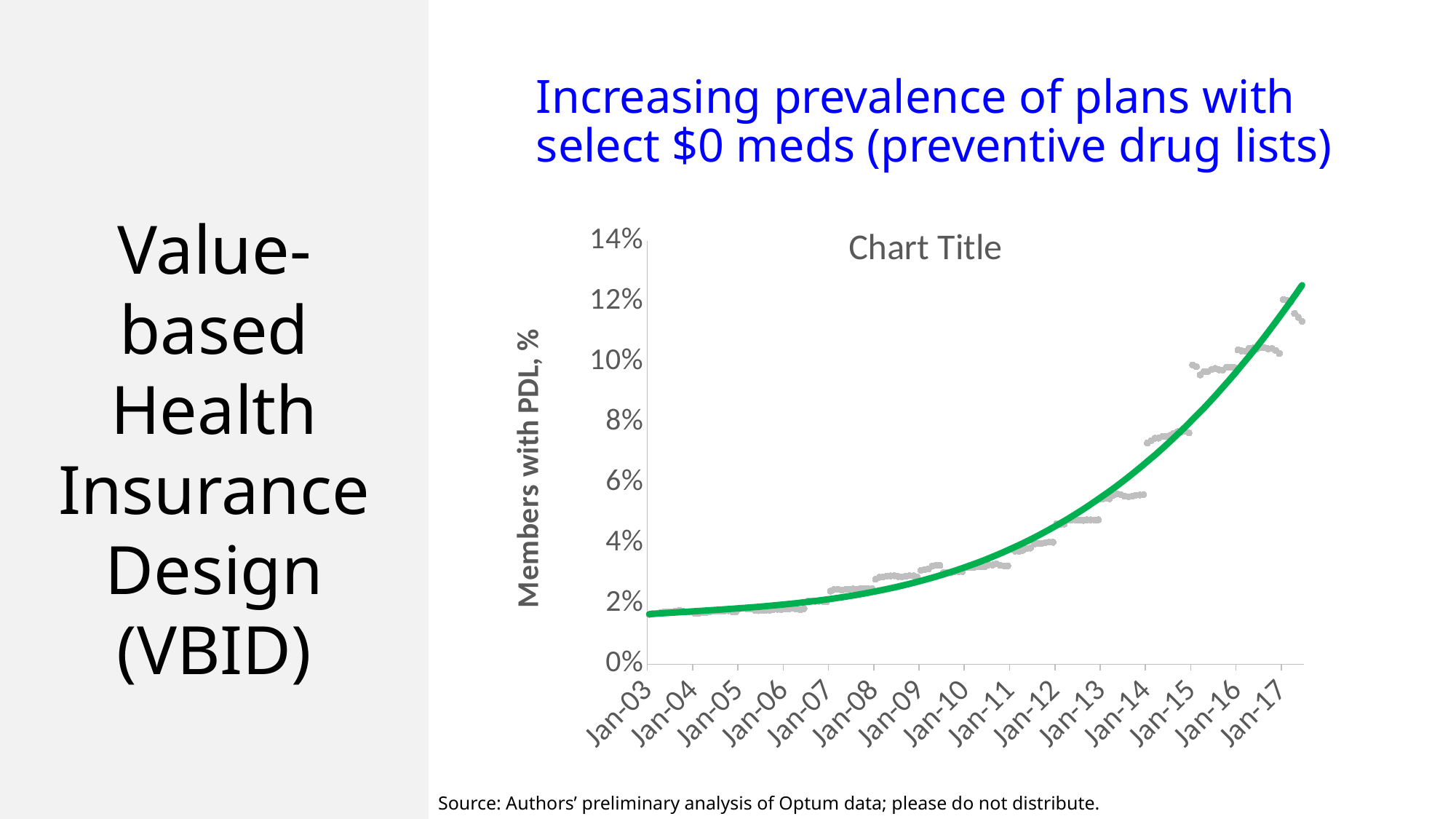
What is the label on the vertical axis? Members with PDL, % Is the value for Jan-15 greater or less than 8%? greater How many year labels are shown on the x axis? 15 What kind of chart is shown on the slide? Line chart Is the value for Jan-14 greater or less than 6%? greater Is the value for Jan-17 greater or less than 10%? greater Do the values rise or fall from Jan-03 to Jan-17? Rise What is the highest value shown on the vertical axis? 14% Which has the higher value, Jan-03 or Jan-17? Jan-17